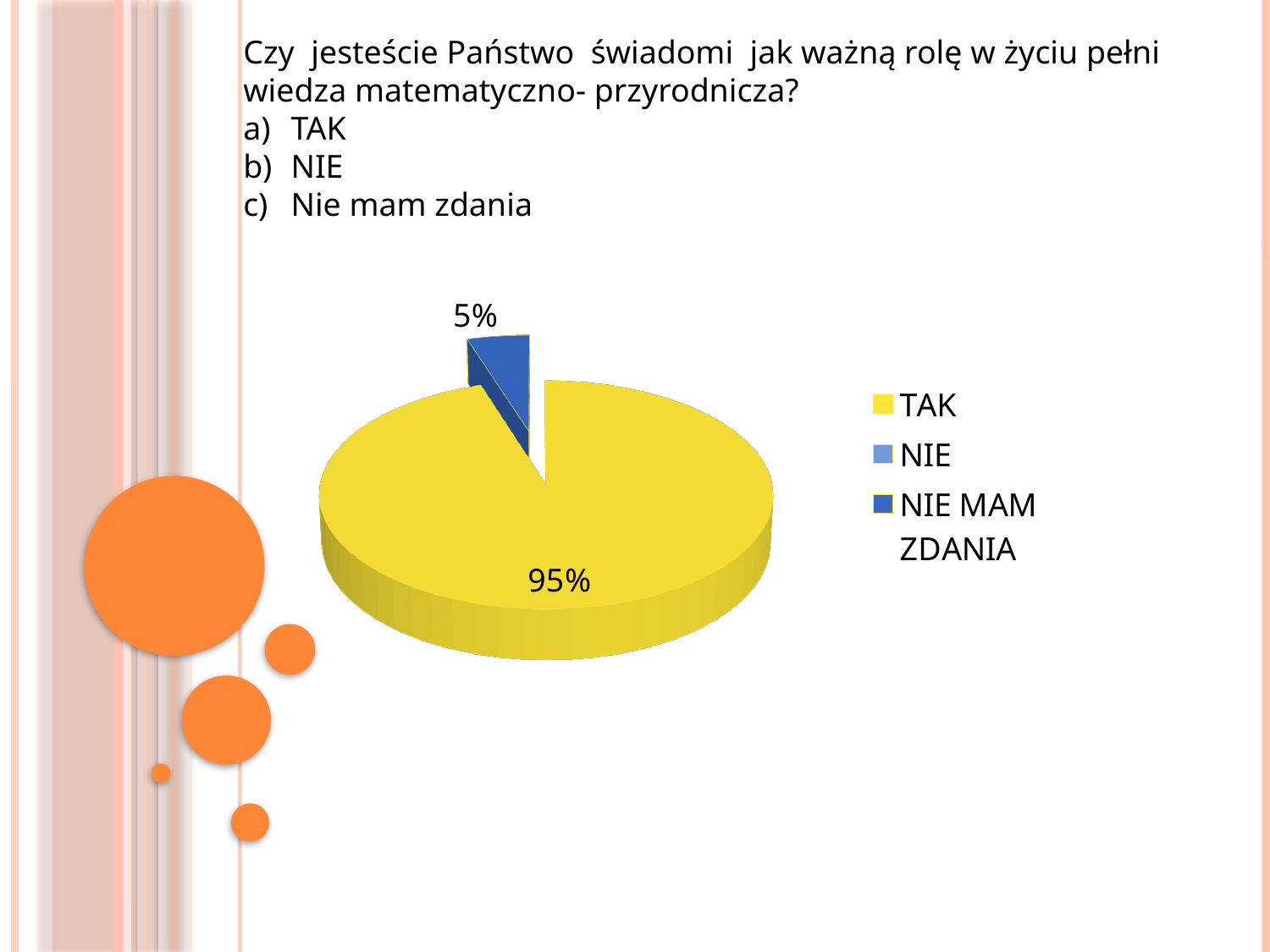
How many slices with data labels are visible in the pie? 2 Which of the two labelled slices is larger, TAK or NIE MAM ZDANIA? TAK What is the difference in percentage points between the TAK slice and the NIE MAM ZDANIA slice? 90 percentage points What share of the pie does TAK have? 95% What share of the pie does NIE MAM ZDANIA have? 5% Is the share for TAK greater or less than 50%? greater Which legend entry is shown in dark blue? NIE MAM ZDANIA How many entries does the legend list? 3 Which category has the largest slice of the pie? TAK What colour is the TAK slice of the pie? Yellow What kind of chart is shown on the slide? Pie chart